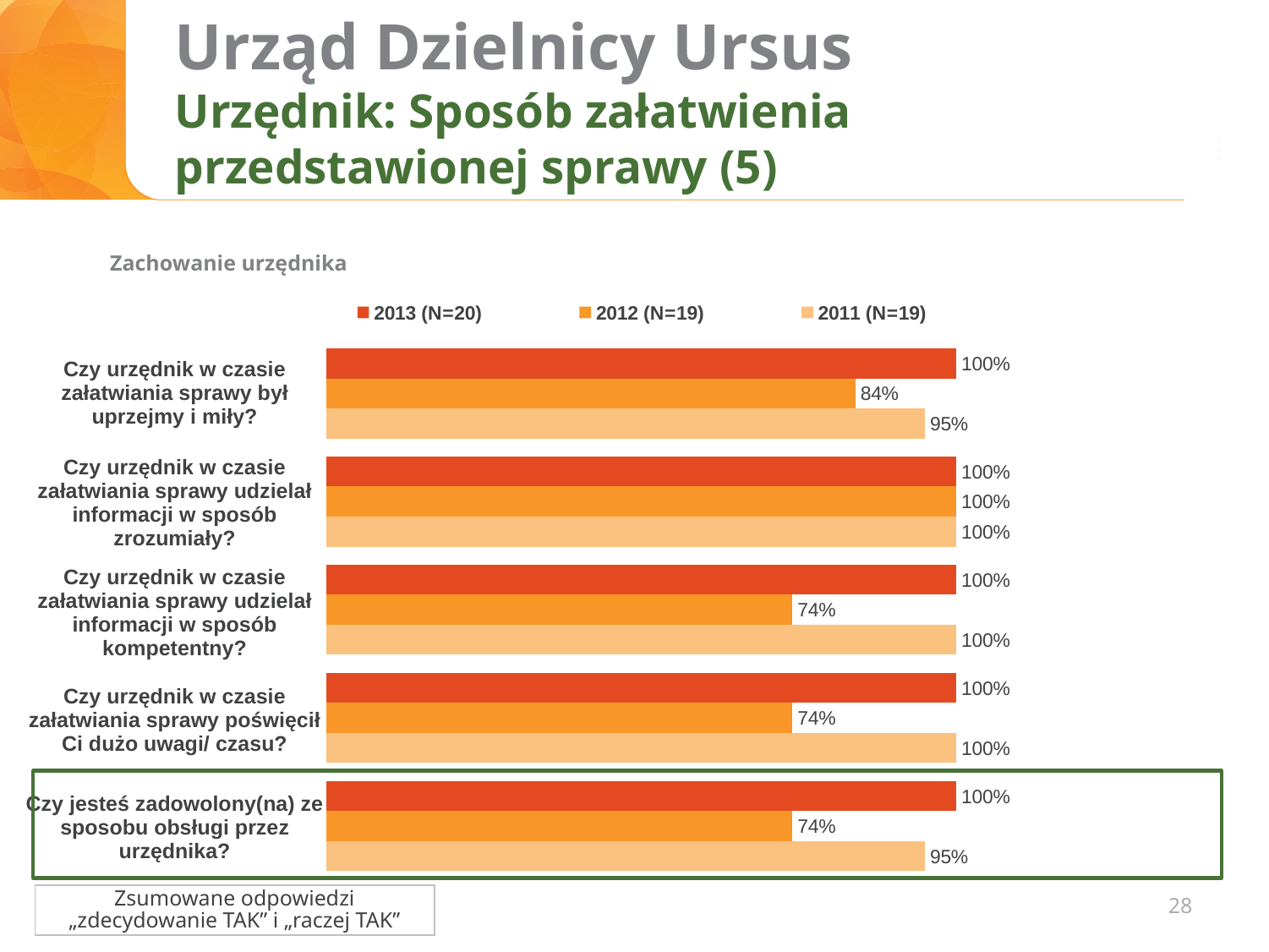
What is the 2013 (N=20) value for "Czy urzędnik w czasie załatwiania sprawy udzielał informacji w sposób kompetentny?"? 100% What type of chart is shown on the slide? bar chart For "Czy urzędnik w czasie załatwiania sprawy był uprzejmy i miły?", which is larger: the 2012 (N=19) value or the 2011 (N=19) value? 2011 (N=19) Which category has the lowest 2011 (N=19) value? Czy urzędnik w czasie załatwiania sprawy był uprzejmy i miły? / Czy jesteś zadowolony(na) ze sposobu obsługi przez urzędnika? (both 95%) What is the 2011 (N=19) value for "Czy jesteś zadowolony(na) ze sposobu obsługi przez urzędnika?"? 95% What is the title shown above the chart? Zachowanie urzędnika How many series does the legend list? 3 What is the difference between the 2013 (N=20) and 2012 (N=19) values for "Czy jesteś zadowolony(na) ze sposobu obsługi przez urzędnika?"? 26 percentage points How many question categories are plotted in the chart? 5 Which category has the highest 2012 (N=19) value? Czy urzędnik w czasie załatwiania sprawy udzielał informacji w sposób zrozumiały? What is the 2012 (N=19) value for "Czy urzędnik w czasie załatwiania sprawy był uprzejmy i miły?"? 84% What is the 2012 (N=19) value for "Czy urzędnik w czasie załatwiania sprawy poświęcił Ci dużo uwagi/ czasu?"? 74%